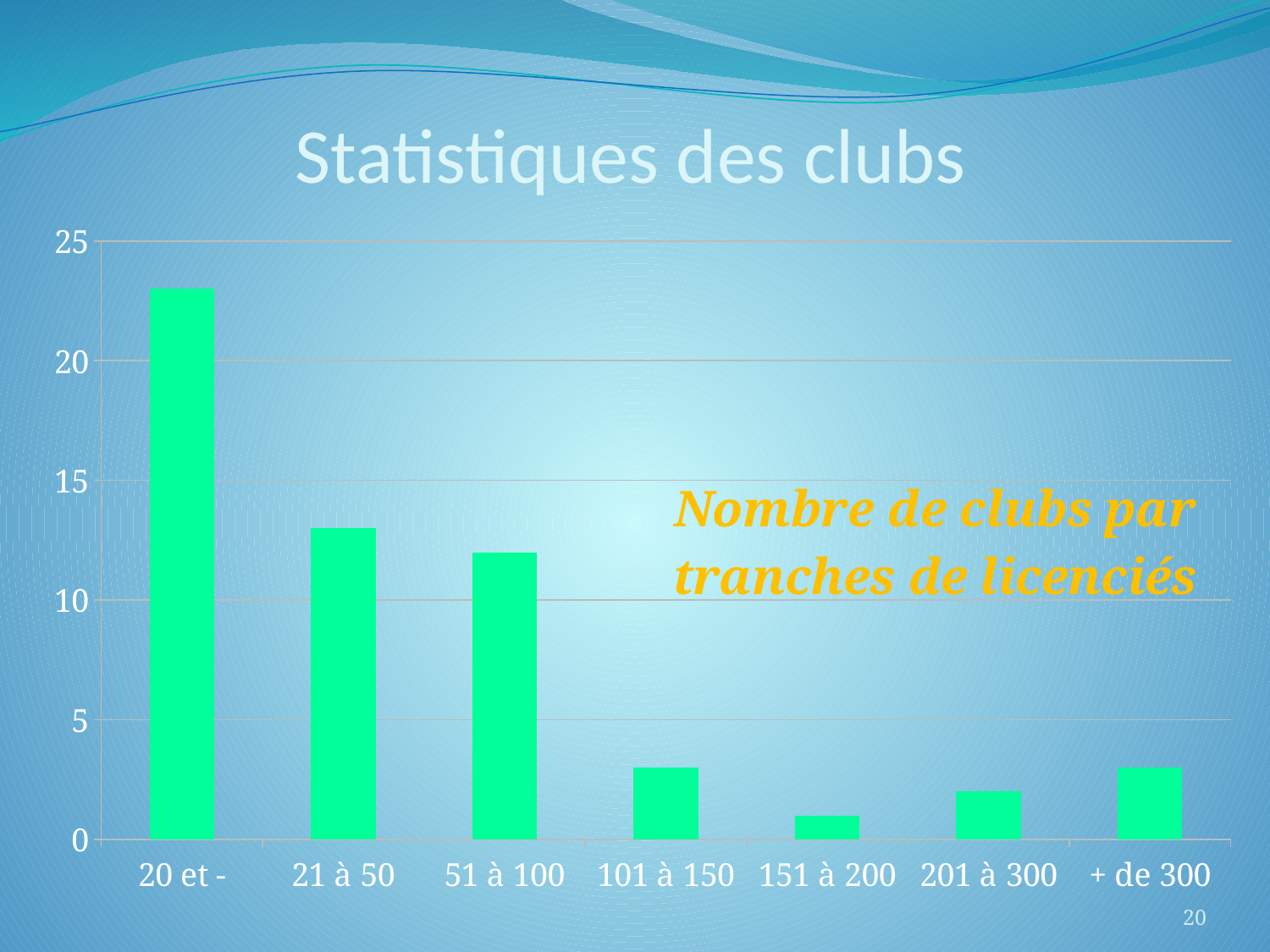
Is the value for "21 à 50" greater or less than 10? greater Which is larger, the value for "101 à 150" or the value for "151 à 200"? 101 à 150 Which category has the lowest number of clubs? 151 à 200 How many categories (tranches de licenciés) are shown on the x axis? 7 What is the title of the slide containing the chart? Statistiques des clubs Is the value for "51 à 100" greater or less than 15? less Is the value for "20 et -" greater or less than 20? greater Which is larger, the value for "20 et -" or the value for "21 à 50"? 20 et - Which category has the highest number of clubs? 20 et - What kind of chart is shown on the slide? bar chart